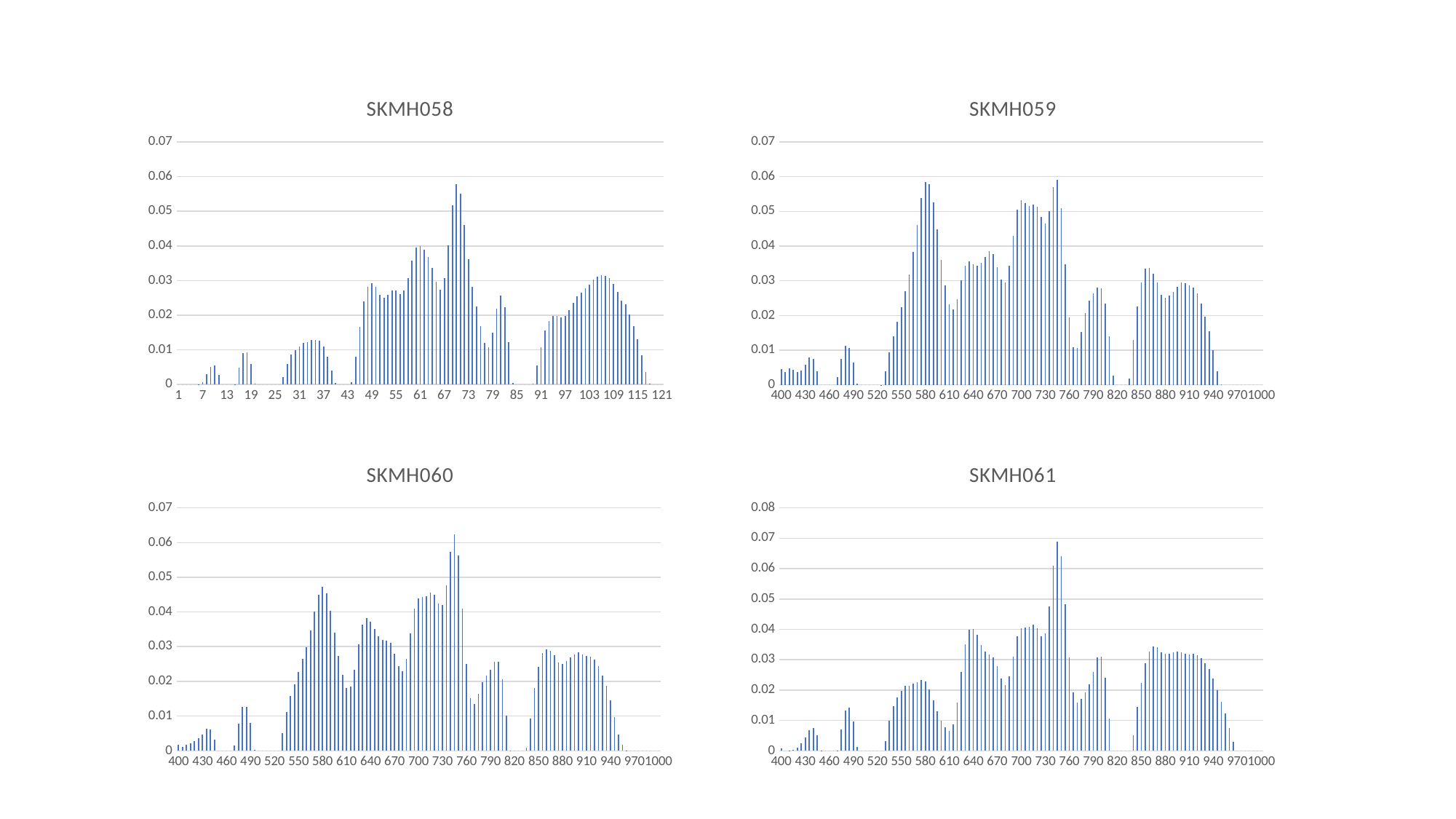
In the SKMH061 chart, what is the highest value shown on the y axis? 0.08 In the SKMH059 chart, is the value at 400 greater or less than 0.01? less In the SKMH058 chart, what is the last label shown on the x axis? 121 In the SKMH058 chart, what is the highest value shown on the y axis? 0.07 In the SKMH058 chart, is the tallest bar greater or less than 0.05? greater What is the title of the chart in the bottom-right position? SKMH061 In the SKMH060 chart, is the tallest bar greater or less than 0.05? greater What kind of chart is SKMH058? bar chart What is the title of the chart in the top-left position? SKMH058 How many charts are shown on the slide? 4